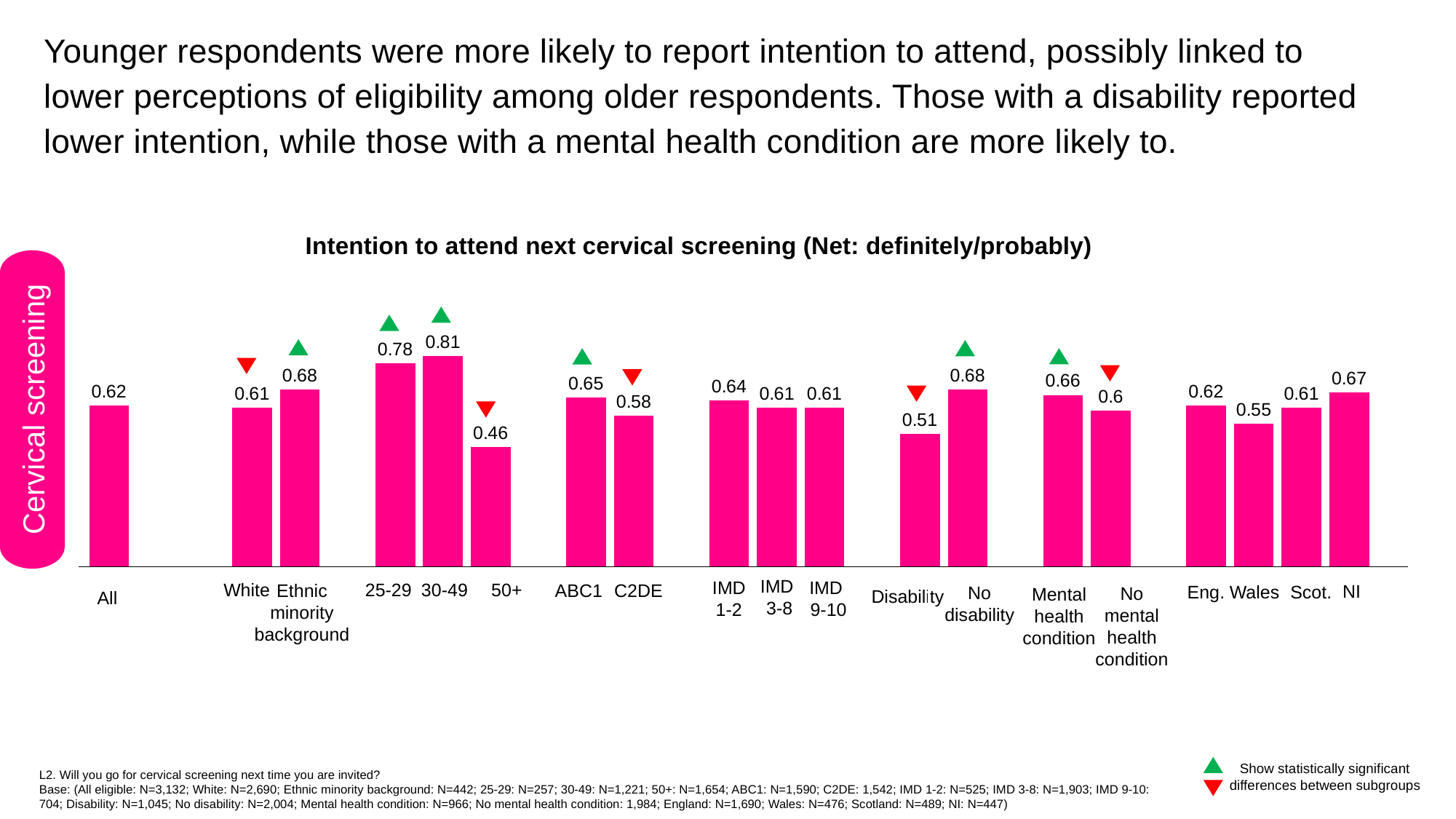
What is the difference between the values for 25-29 and 50+? 0.32 What type of chart is shown on the slide? Bar chart What is the value for Wales? 0.55 What is the title of the chart? Intention to attend next cervical screening (Net: definitely/probably) Which category has the lowest value? 50+ What is the value for the All category? 0.62 What is the difference between the values for No disability and Disability? 0.17 What is the value for Disability? 0.51 Which category has the highest value? 30-49 What is the value for the 30-49 age group? 0.81 Which is larger, the value for ABC1 or the value for C2DE? ABC1 How many bars are plotted in the chart? 19